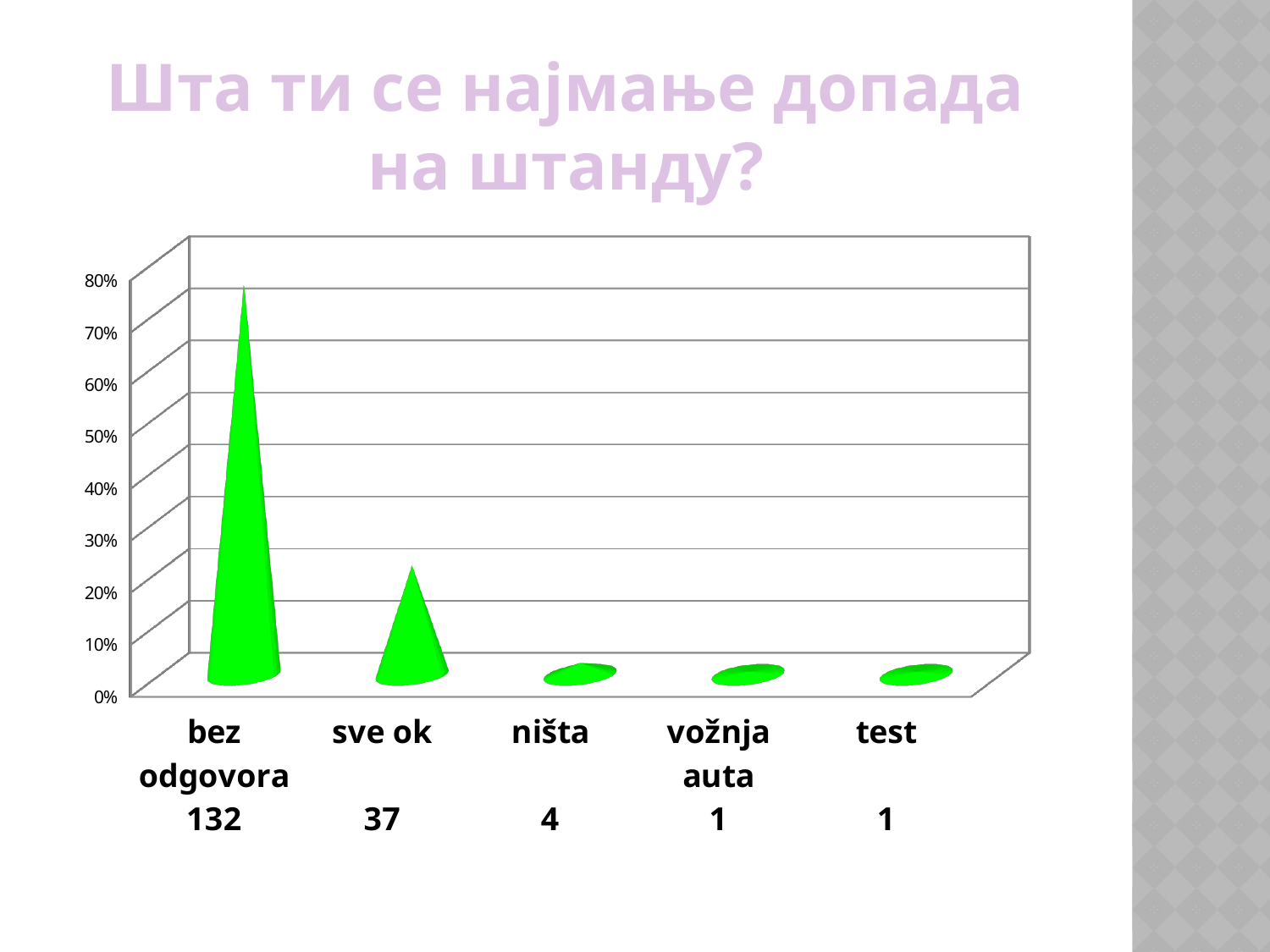
What is the title of the slide above the chart? Шта ти се најмање допада на штанду? Which is larger, the value for 'bez odgovora' or the value for 'sve ok'? bez odgovora Which is larger, the value for 'sve ok' or the value for 'ništa'? sve ok Is the value for 'ništa' greater or less than 10%? less How many categories are shown on the x axis of the chart? 5 Is the value for 'sve ok' greater or less than 30%? less Is the value for 'bez odgovora' greater or less than 70%? greater What number is printed under the category label 'sve ok'? 37 What number is printed under the category label 'bez odgovora'? 132 Do the values rise or fall from left to right along the x axis? fall Which category has the highest value in the chart? bez odgovora What kind of chart is shown on the slide? bar chart